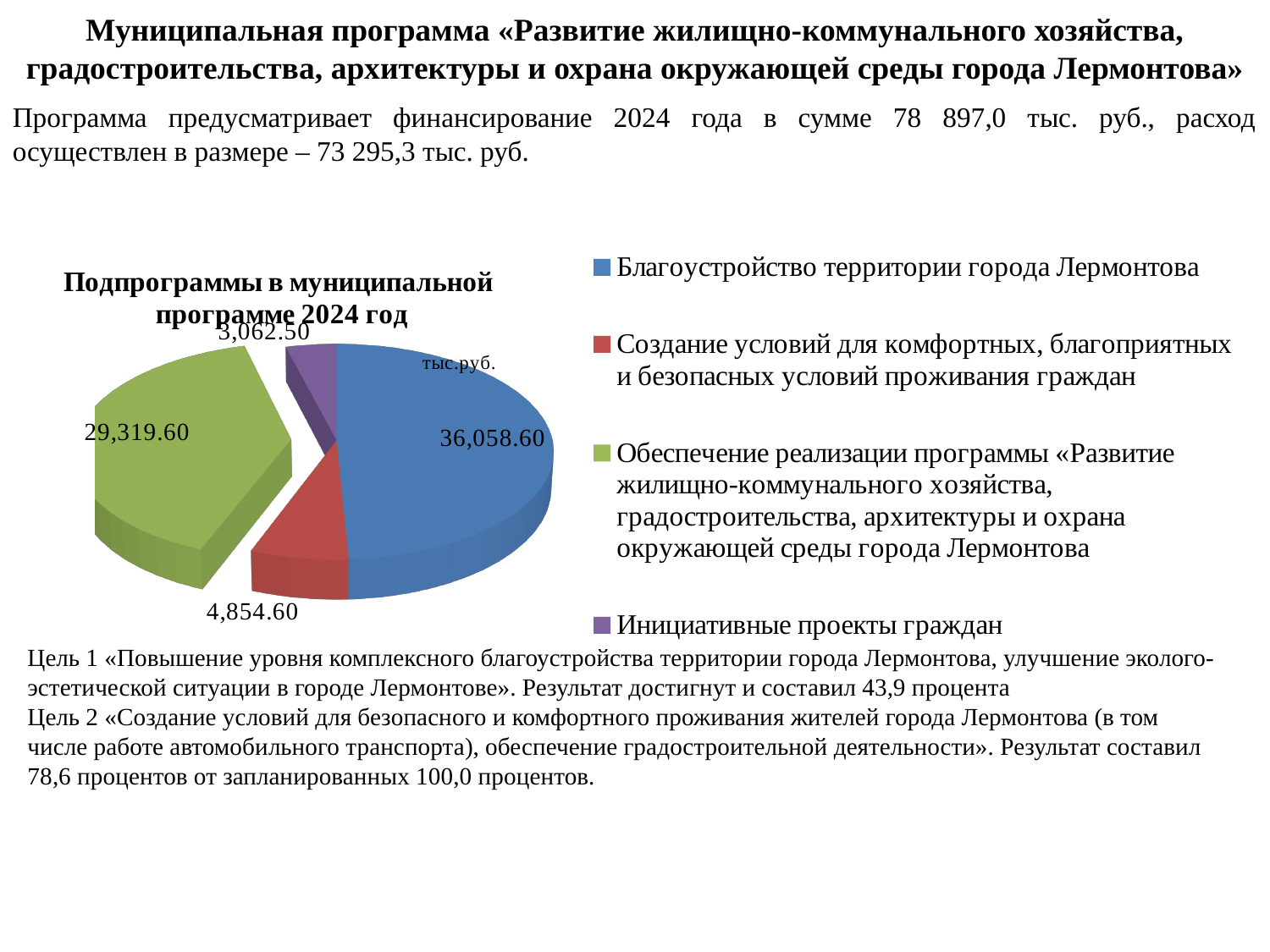
What is the difference between the values for «Благоустройство территории города Лермонтова» and «Обеспечение реализации программы...»? 6,739.00 Which subprogram has the smallest slice of the pie? Инициативные проекты граждан Which subprogram has the largest slice of the pie? Благоустройство территории города Лермонтова Which is larger: the value for «Создание условий для комфортных, благоприятных и безопасных условий проживания граждан» or for «Инициативные проекты граждан»? Создание условий для комфортных, благоприятных и безопасных условий проживания граждан What is the title of the chart? Подпрограммы в муниципальной программе 2024 год What colour is the slice for «Обеспечение реализации программы...» in the pie chart? Green What is the value for «Обеспечение реализации программы «Развитие жилищно-коммунального хозяйства, градостроительства, архитектуры и охрана окружающей среды города Лермонтова»? 29,319.60 What is the value for «Создание условий для комфортных, благоприятных и безопасных условий проживания граждан»? 4,854.60 What is the value for «Инициативные проекты граждан»? 3,062.50 How many slices does the pie chart have? 4 What is the value for «Благоустройство территории города Лермонтова»? 36,058.60 What type of chart is shown on the slide? Pie chart